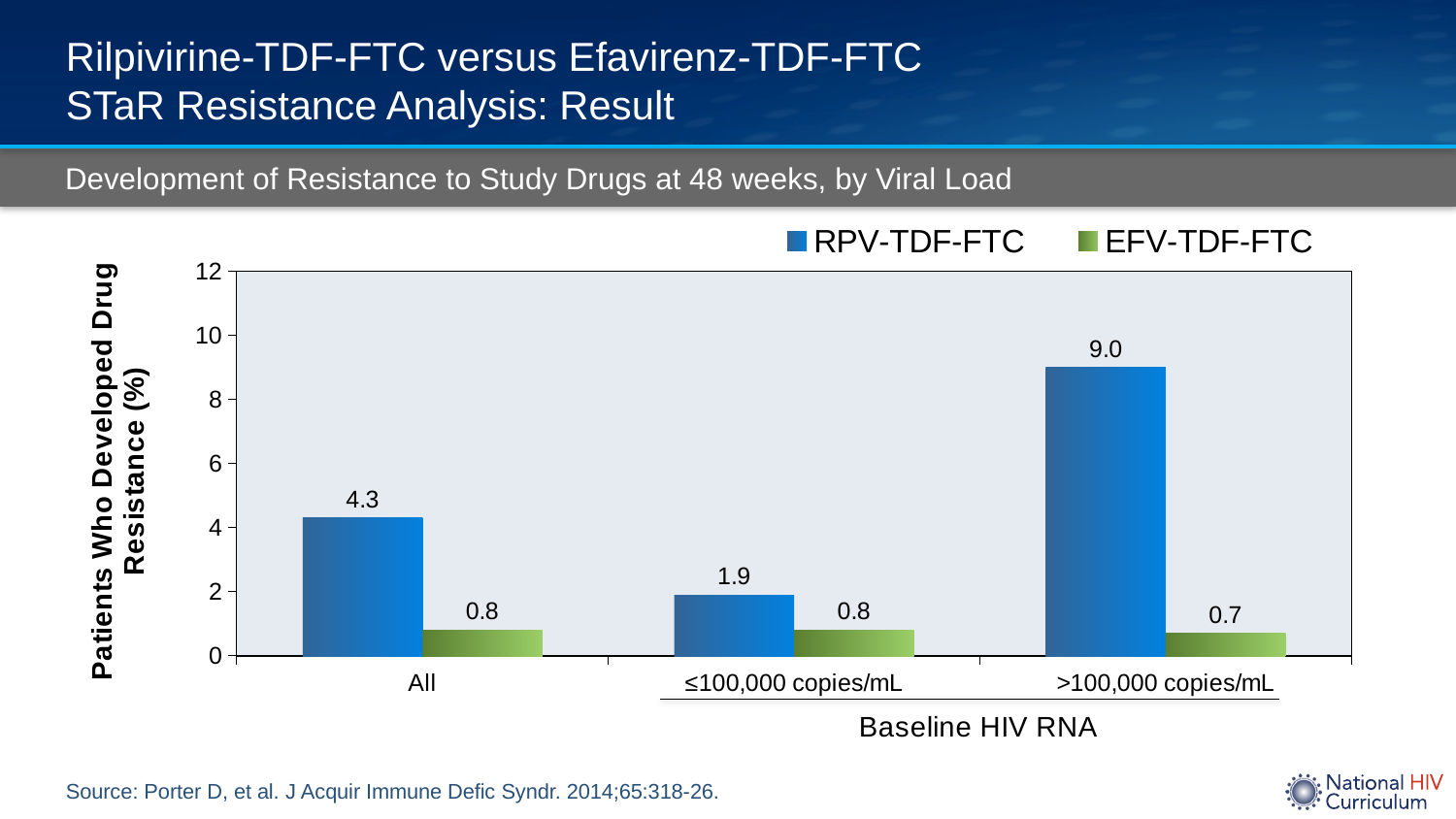
What is the difference between the RPV-TDF-FTC and EFV-TDF-FTC values in the >100,000 copies/mL category? 8.3 How many categories are shown on the x axis? 3 What kind of chart is shown on the slide? Bar chart Which category has the lowest value for EFV-TDF-FTC? >100,000 copies/mL What is the value for EFV-TDF-FTC in the >100,000 copies/mL category? 0.7 Which is larger in the All category, RPV-TDF-FTC or EFV-TDF-FTC? RPV-TDF-FTC Is the value for RPV-TDF-FTC in the >100,000 copies/mL category greater or less than 8? greater What is the value for RPV-TDF-FTC in the All category? 4.3 What is the difference between the RPV-TDF-FTC values for >100,000 copies/mL and ≤100,000 copies/mL? 7.1 What is the value for RPV-TDF-FTC in the ≤100,000 copies/mL category? 1.9 Which category has the highest value for RPV-TDF-FTC? >100,000 copies/mL How many series does the legend list? 2